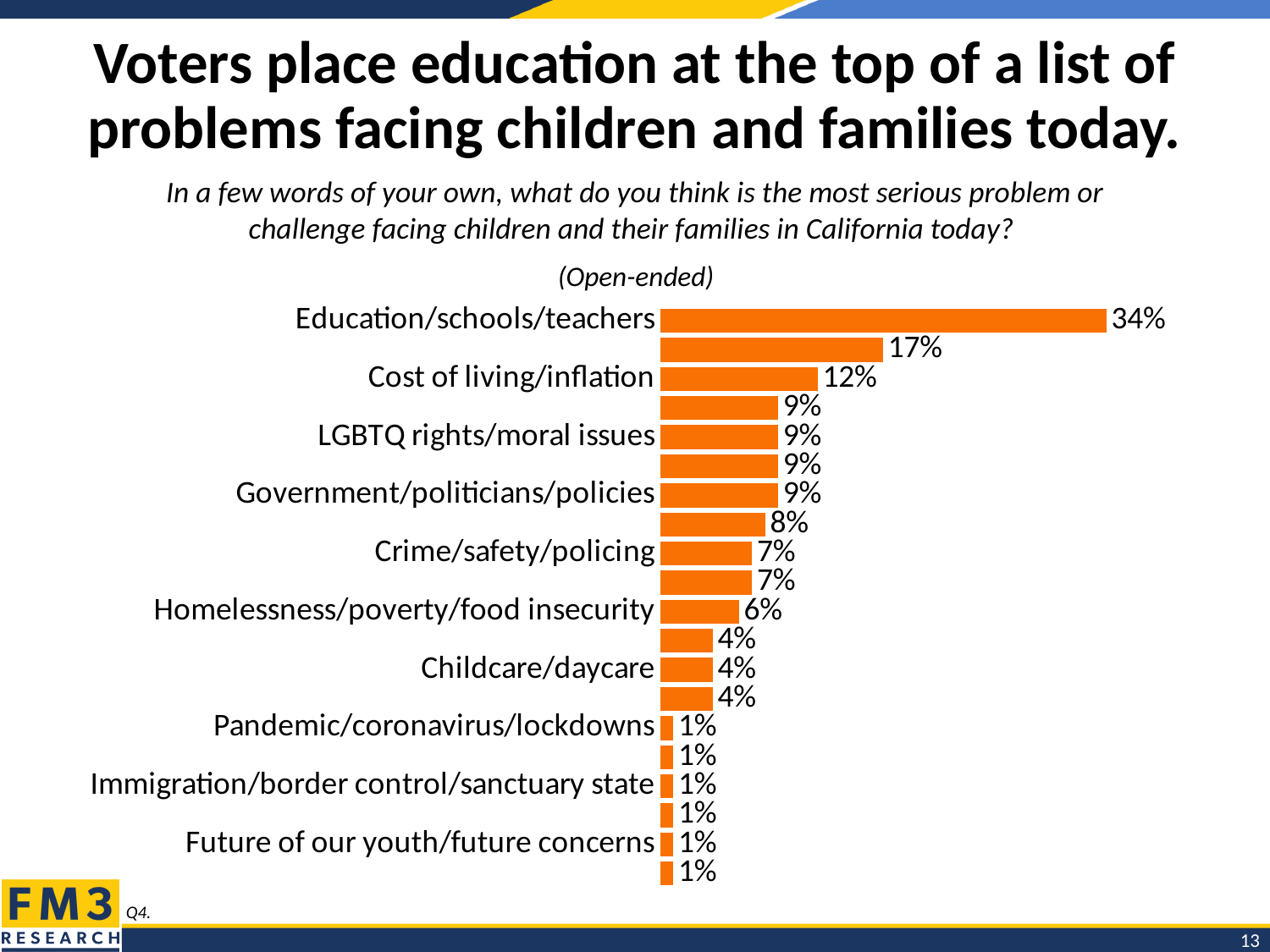
What is the value for Homelessness/poverty/food insecurity? 6% What is the difference between the values for Education/schools/teachers and Cost of living/inflation? 22 percentage points Which category has the highest value in the chart? Education/schools/teachers What percentage is shown for Crime/safety/policing? 7% What kind of chart is shown on the slide? Bar chart What percentage is shown for Childcare/daycare? 4% How many bars are plotted in the chart? 20 What is the value for Pandemic/coronavirus/lockdowns? 1% Do the bar values increase or decrease going from the top of the chart to the bottom? Decrease Which is larger, the value for Crime/safety/policing or the value for Childcare/daycare? Crime/safety/policing What percentage of voters named Education/schools/teachers as the most serious problem? 34% What is the value shown for Cost of living/inflation? 12%